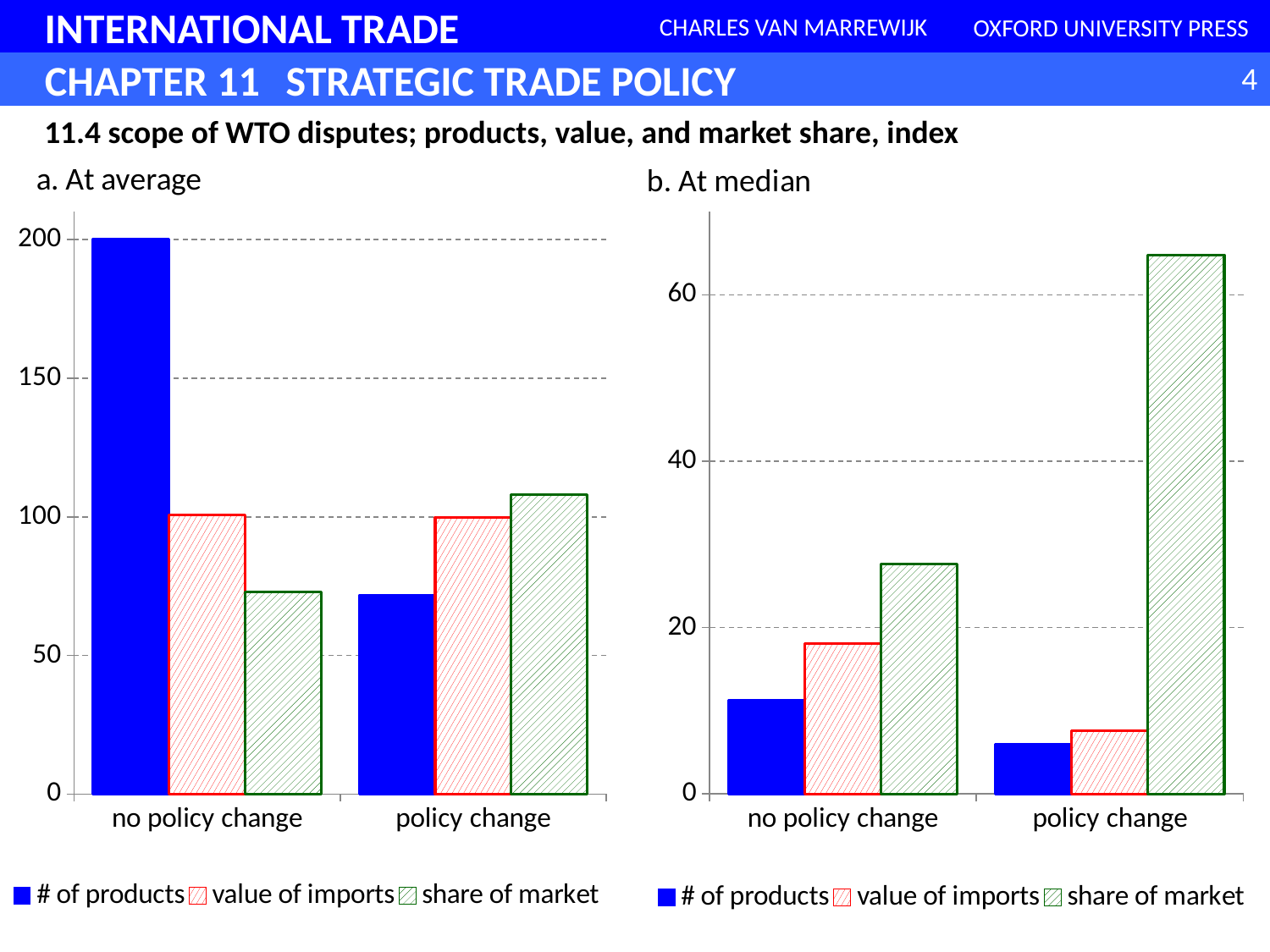
In the 'b. At median' chart, which series has the lowest value for 'policy change'? # of products In the 'a. At average' chart, which series has the highest value for 'no policy change'? # of products In the 'b. At median' chart, which series has the highest value for 'policy change'? share of market In the 'b. At median' chart, is the value of 'share of market' for 'policy change' greater or less than 60? greater In the 'b. At median' chart, is 'share of market' larger for 'no policy change' or for 'policy change'? policy change What kind of chart is the 'a. At average' chart? bar chart In the 'b. At median' chart, how many series does the legend list? 3 In the 'a. At average' chart, is the value of 'share of market' for 'no policy change' greater or less than 100? less What are the three legend entries of the 'a. At average' chart? # of products, value of imports, share of market In the 'a. At average' chart, does the '# of products' series rise or fall from 'no policy change' to 'policy change'? fall In the 'a. At average' chart, what is the value of '# of products' for 'no policy change'? 200 In the 'a. At average' chart, how many categories are shown on the x axis? 2